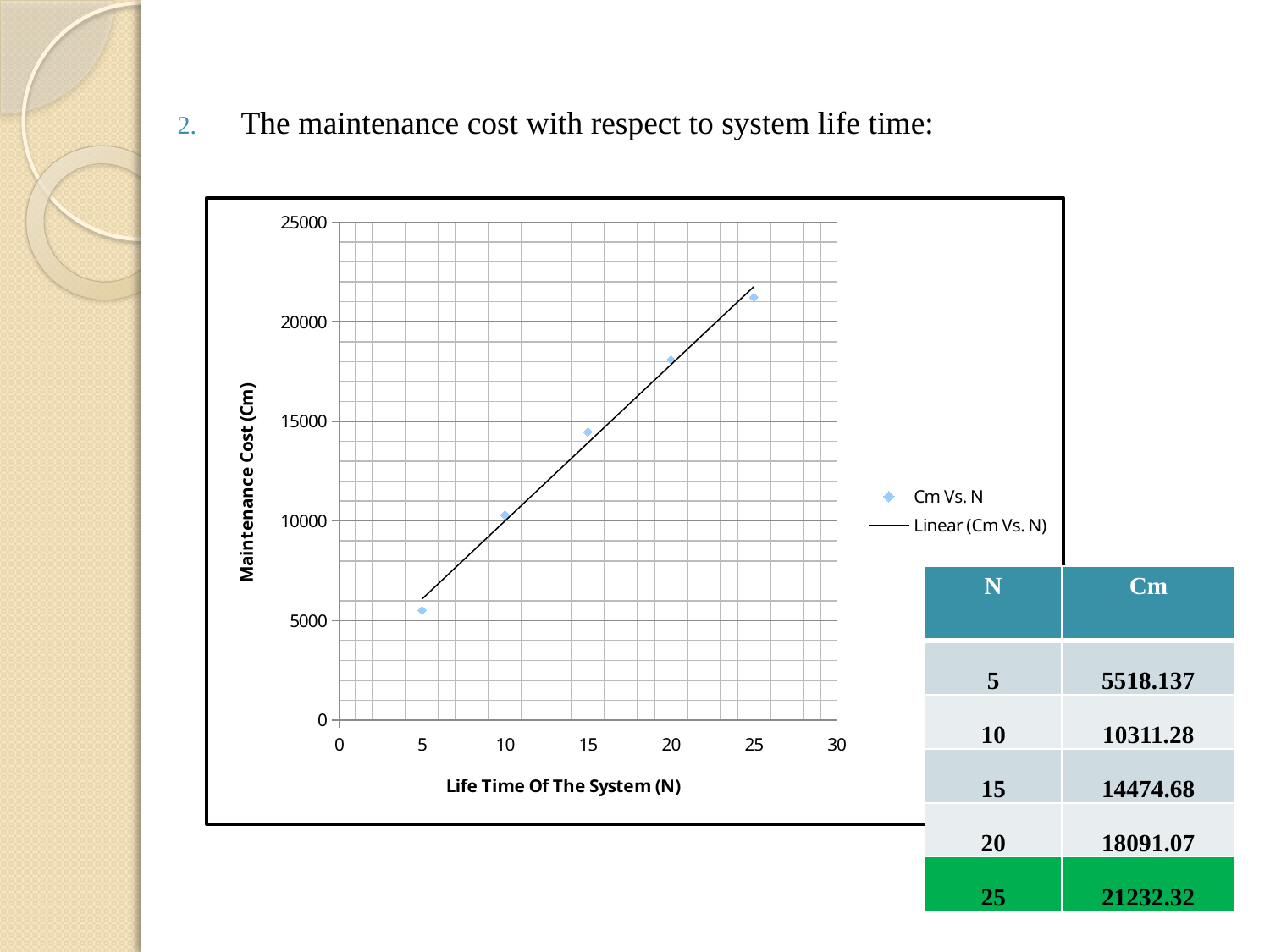
What is the label of the x axis? Life Time Of The System (N) At which value of N is the maintenance cost lowest? 5 Is the maintenance cost at N = 10 greater or less than 15000? less According to the table, what is the maintenance cost Cm when N is 15? 14474.68 According to the table, what is the maintenance cost Cm when N is 25? 21232.32 What is the label of the y axis? Maintenance Cost (Cm) How many entries does the chart legend list? 2 How many data points are plotted in the Cm Vs. N series? 5 At which value of N is the maintenance cost highest? 25 Does the maintenance cost rise or fall as the system life time N increases? rise What type of chart is shown on the slide? scatter chart Is the maintenance cost at N = 20 greater or less than 15000? greater